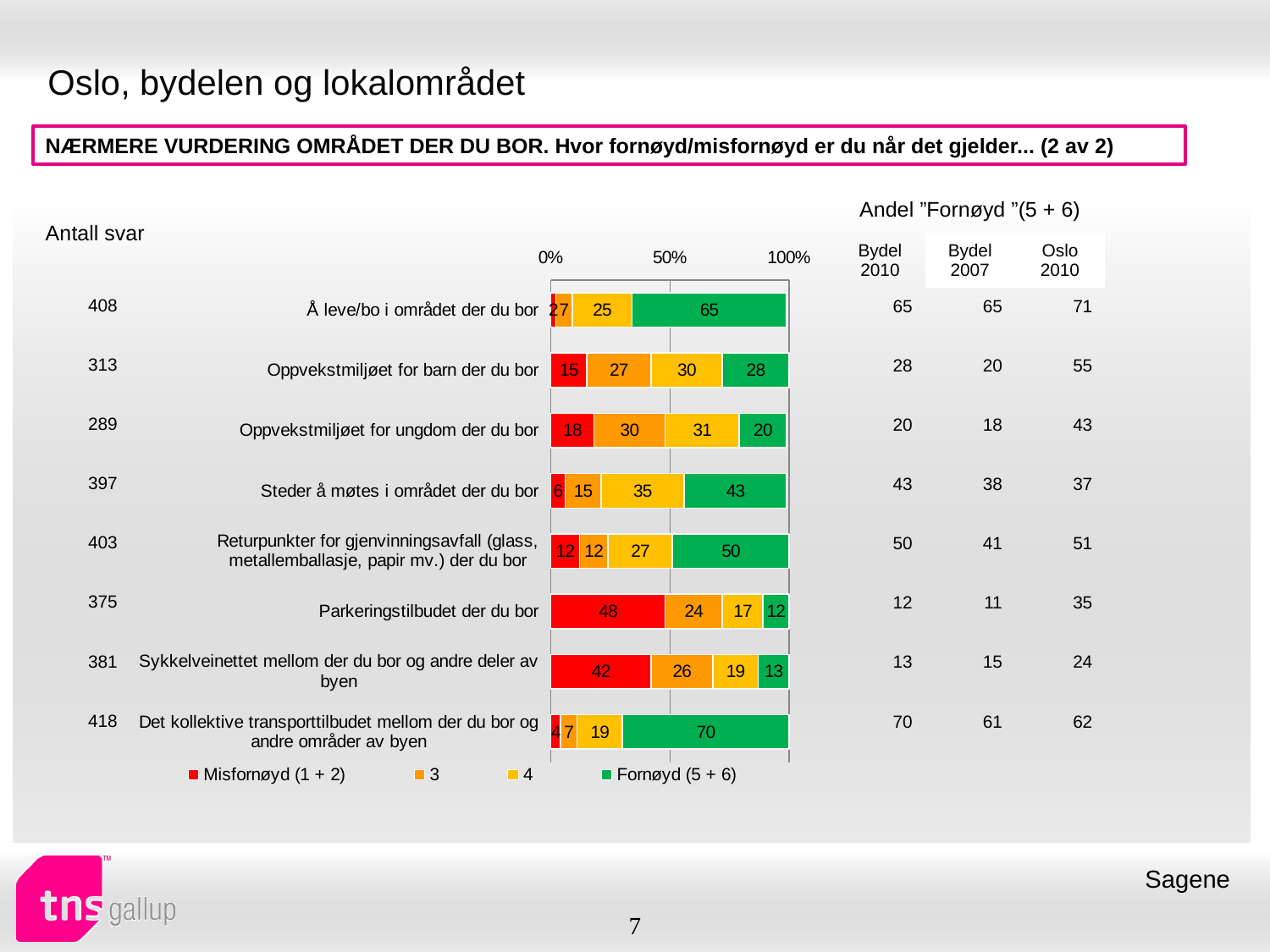
What is the Fornøyd (5 + 6) value for Parkeringstilbudet der du bor? 12 What is the value of series 3 for Oppvekstmiljøet for barn der du bor? 27 Which has the larger Misfornøyd (1 + 2) value: Parkeringstilbudet der du bor or Sykkelveinettet mellom der du bor og andre deler av byen? Parkeringstilbudet der du bor Which category has the lowest Fornøyd (5 + 6) value in the bar chart? Parkeringstilbudet der du bor What is the difference between the Fornøyd (5 + 6) values for Steder å møtes i området der du bor and Oppvekstmiljøet for ungdom der du bor? 23 What is the total of the stacked bar for Oppvekstmiljøet for barn der du bor? 100 What kind of chart is shown on the slide? bar chart What is the Misfornøyd (1 + 2) value for Sykkelveinettet mellom der du bor og andre deler av byen? 42 Which category has the highest Fornøyd (5 + 6) value in the bar chart? Det kollektive transporttilbudet mellom der du bor og andre områder av byen What is the first entry in the chart legend? Misfornøyd (1 + 2) How many series does the chart legend list? 4 How many categories (rows) does the bar chart show? 8